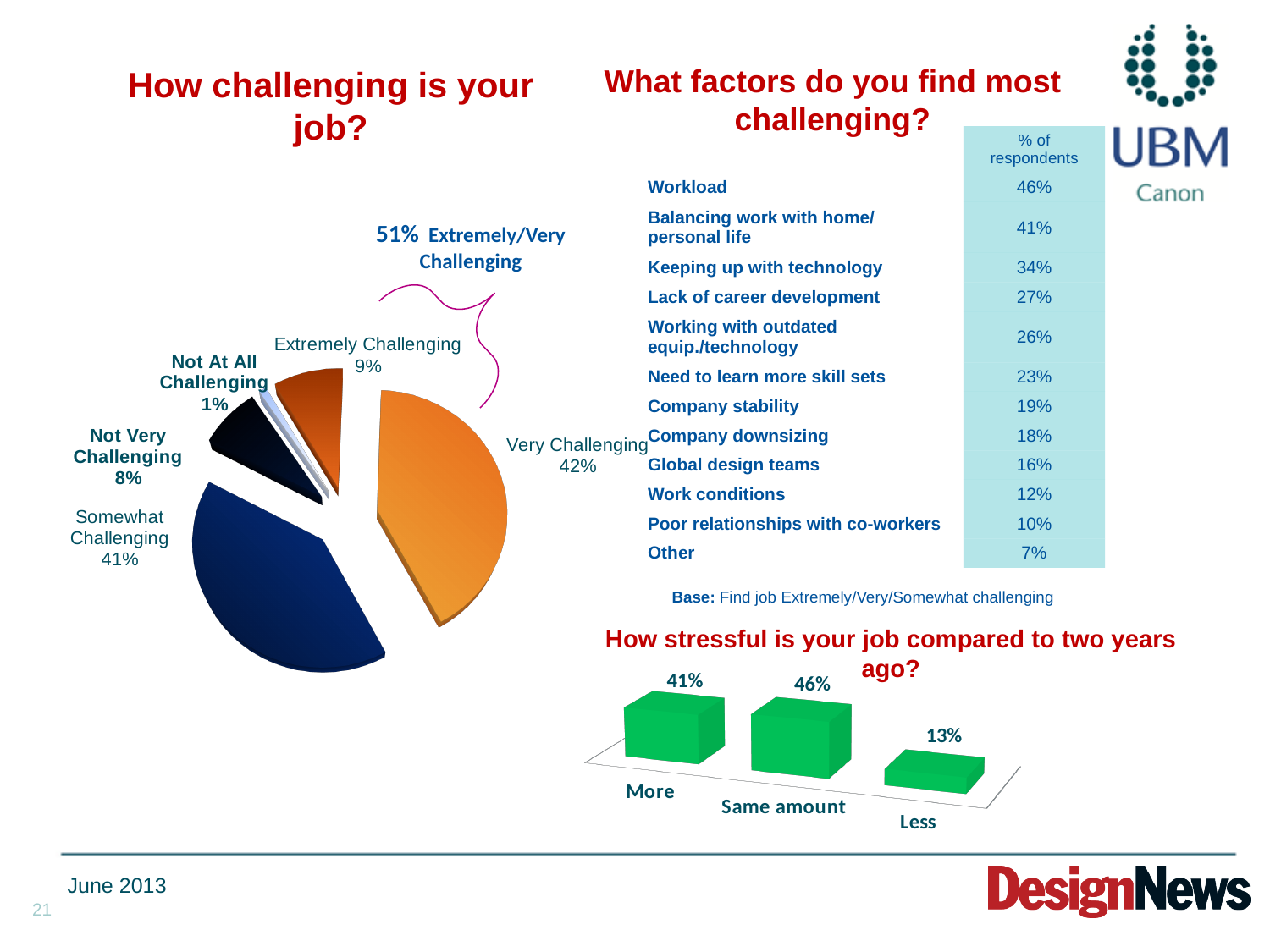
How many categories are shown in the 'How challenging is your job?' pie chart? 5 What kind of chart is the 'How stressful is your job compared to two years ago?' chart? Bar chart In the 'How challenging is your job?' chart, what percentage of respondents find their job Very Challenging? 42% In the 'How challenging is your job?' chart, what percentage of respondents find their job Somewhat Challenging? 41% In the 'How challenging is your job?' chart, what is the difference between the Extremely Challenging and Not Very Challenging percentages? 1% In the 'How stressful is your job compared to two years ago?' chart, which category has the lowest value? Less What kind of chart is the 'How challenging is your job?' chart? Pie chart In the 'How challenging is your job?' chart, which category has the smallest slice? Not At All Challenging In the 'How stressful is your job compared to two years ago?' chart, what percentage of respondents answered Same amount? 46% In the 'How stressful is your job compared to two years ago?' chart, what is the difference between the More and Less values? 28% In the 'How challenging is your job?' chart, which category has the largest slice? Very Challenging In the 'How challenging is your job?' chart, what percentage of respondents find their job Not At All Challenging? 1%